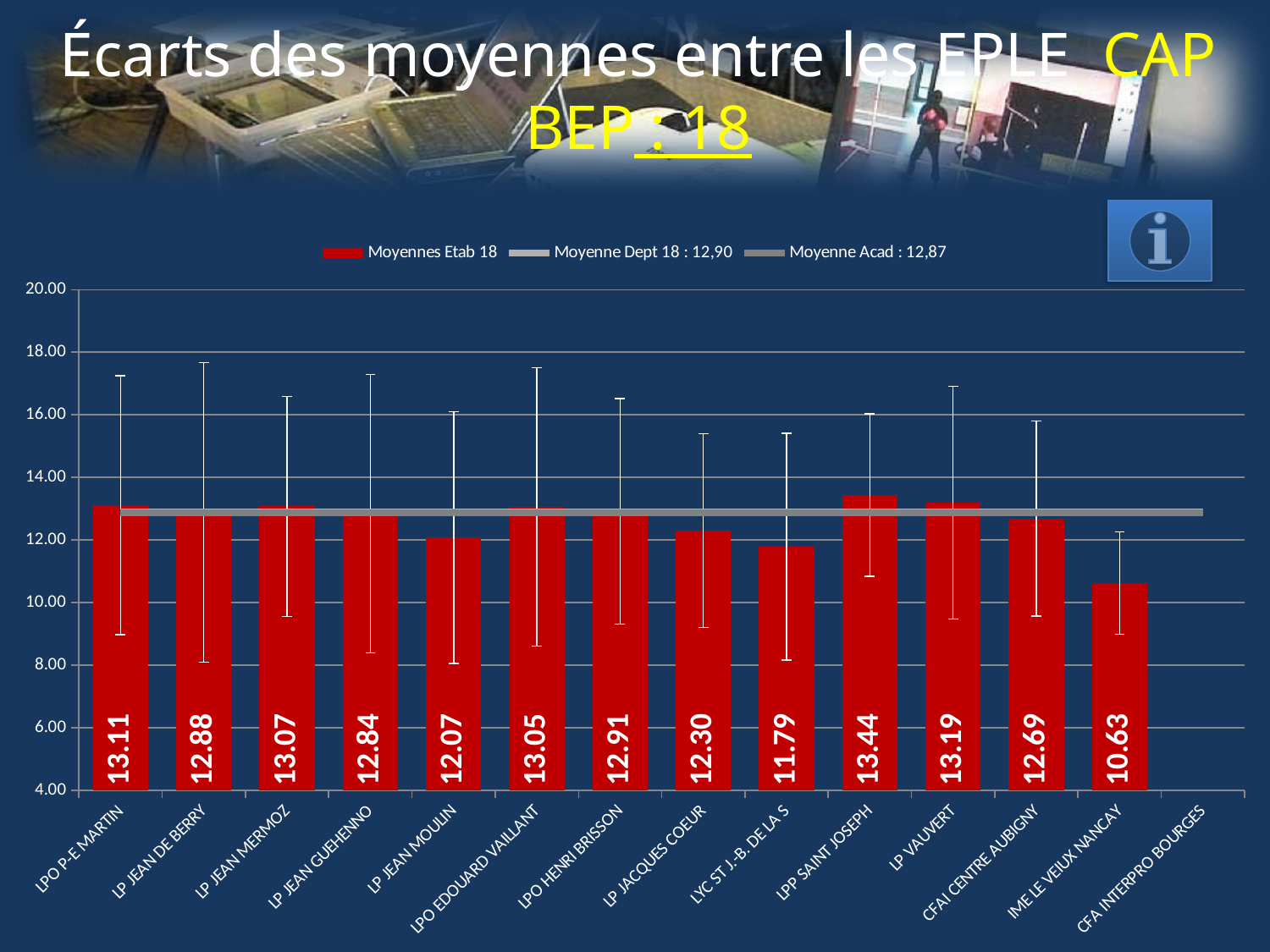
Which establishment has the highest value? LPP SAINT JOSEPH Which establishment has the lowest plotted value? IME LE VIEUX NANCAY What is the value for IME LE VIEUX NANCAY? 10.63 What is the difference between the values for LPP SAINT JOSEPH and IME LE VIEUX NANCAY? 2.81 How many series does the legend list? 3 What value does the legend give for Moyenne Dept 18? 12,90 Which is larger, the value for LP VAUVERT or the value for LP JEAN MOULIN? LP VAUVERT Is the value for LYC ST J.-B. DE LA S greater or less than 12.00? less What is the value for LPP SAINT JOSEPH? 13.44 What is the value for LP JEAN MOULIN? 12.07 What kind of chart is shown? bar chart How many red bars with data labels are plotted? 13